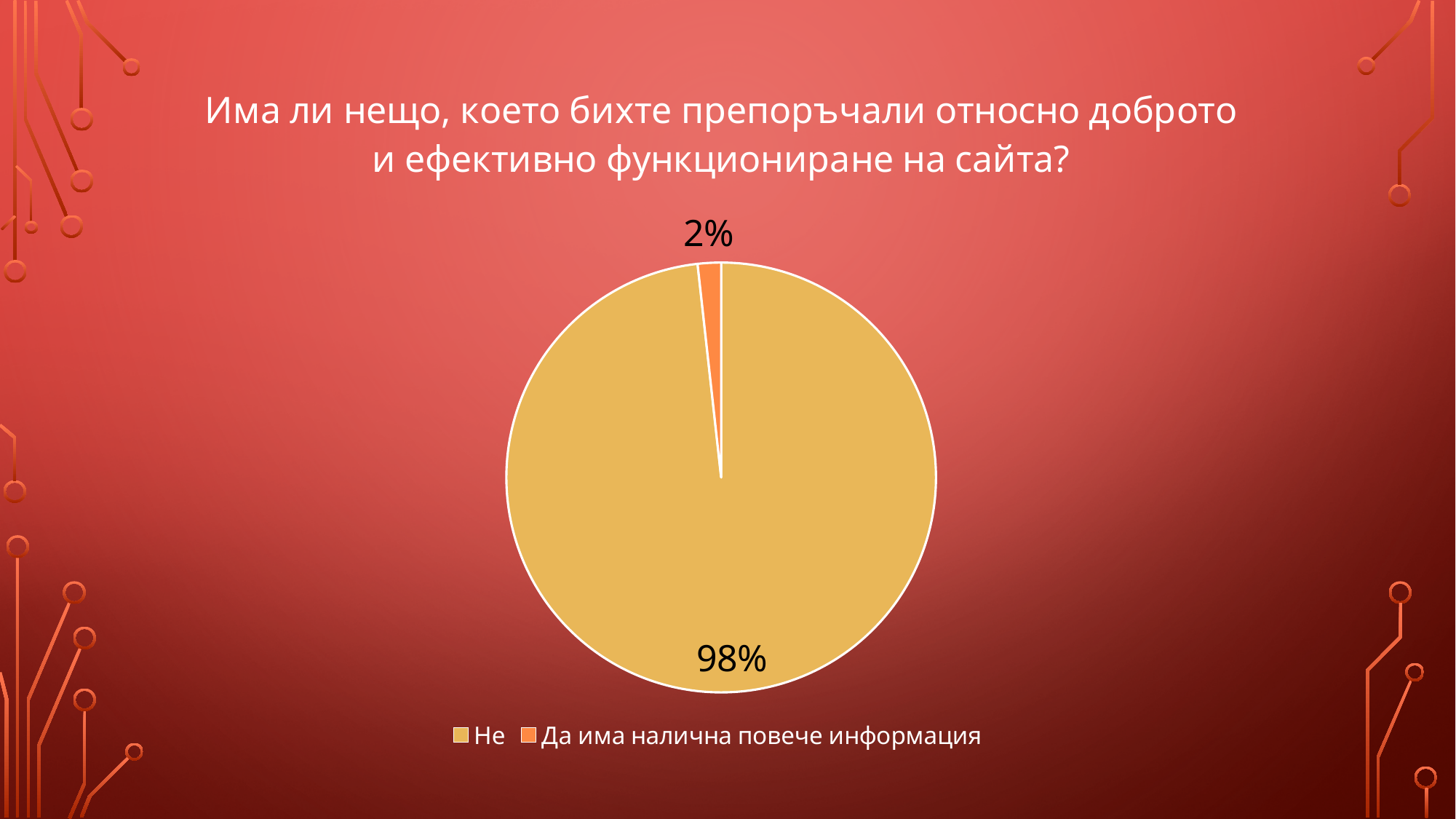
What colour is the slice for "Не"? gold/yellow Which is larger: the slice for "Не" or the slice for "Да има налична повече информация"? Не How many categories does the pie chart show? 2 What is the title of the chart? Има ли нещо, което бихте препоръчали относно доброто и ефективно функциониране на сайта? What kind of chart is shown on the slide? pie chart What share of the pie does "Да има налична повече информация" represent? 2% Which category has the largest slice of the pie? Не How many entries does the legend list? 2 What is the difference in percentage points between the "Не" slice and the "Да има налична повече информация" slice? 96 What share of the pie does "Не" represent? 98% Which category has the smallest slice of the pie? Да има налична повече информация